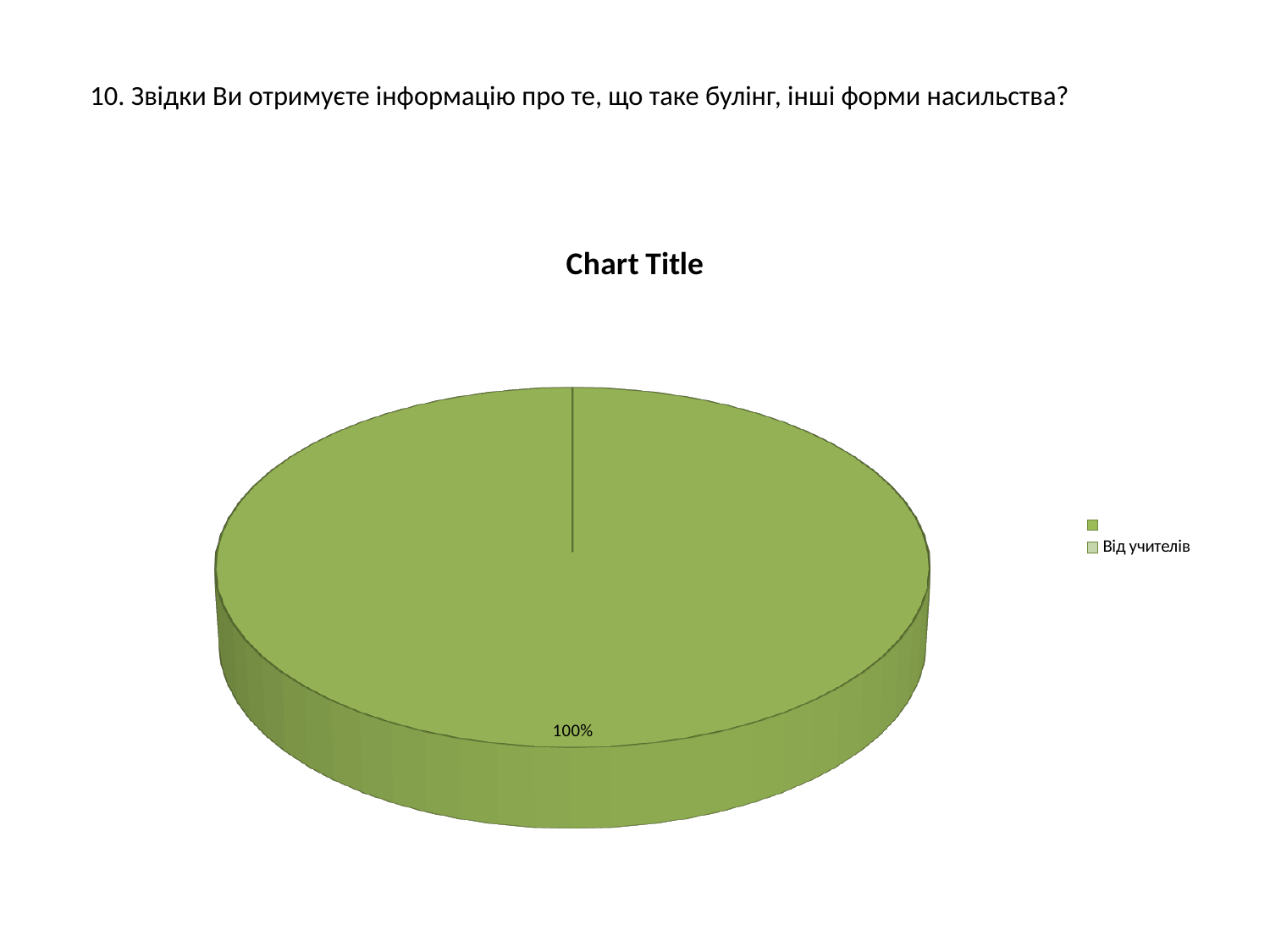
What data label is printed on the pie slice? 100% How many slices are visible in the pie chart? 1 What colour is the pie slice labelled "Від учителів"? green What kind of chart is shown on the slide? pie chart What is the title of the chart? Chart Title